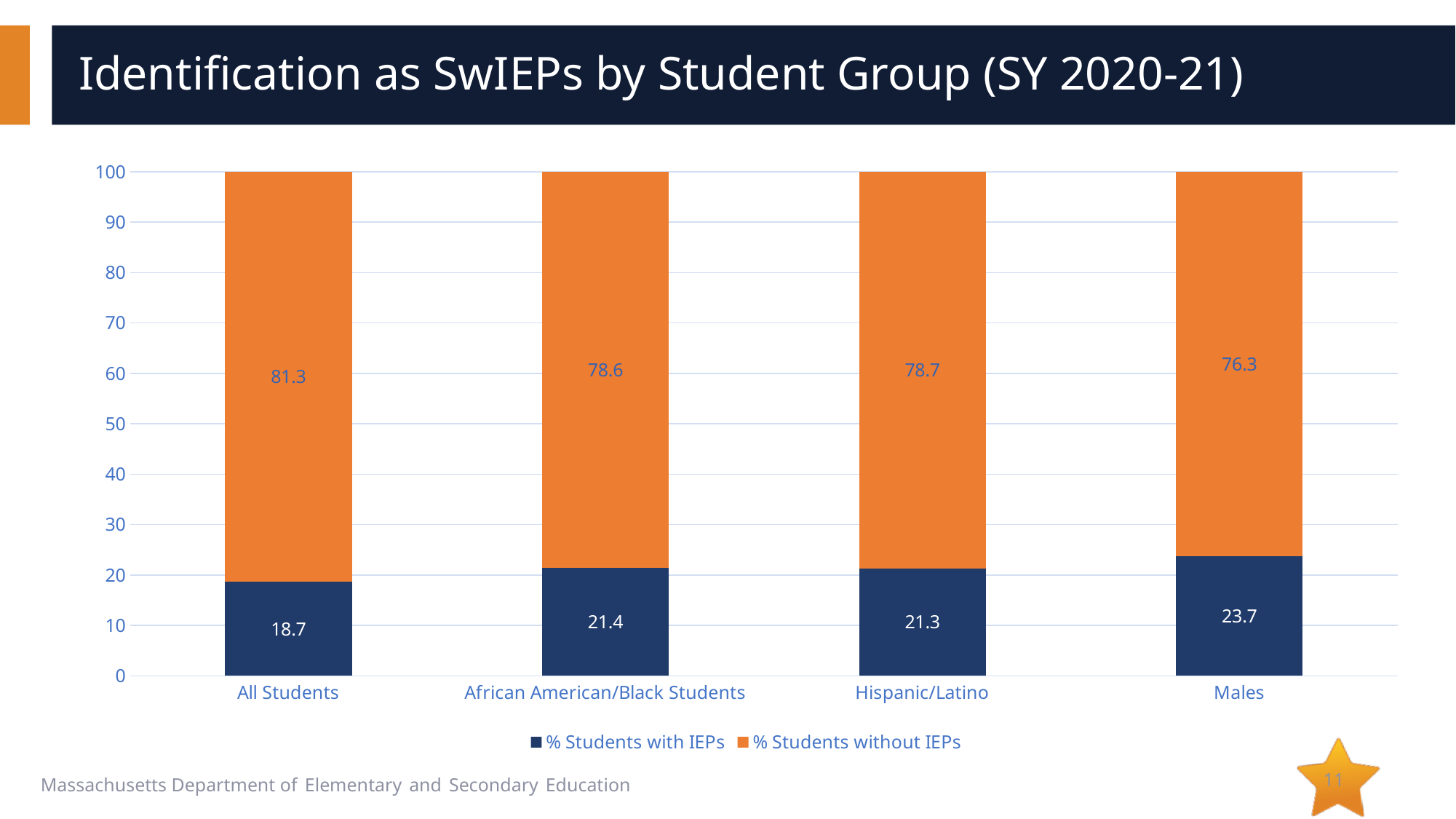
Which is larger: the % Students with IEPs for African American/Black Students or for All Students? African American/Black Students What is the total of the stacked bar for Hispanic/Latino? 100 What is the % Students with IEPs value for Hispanic/Latino? 21.3 How many student groups are shown on the x axis? 4 What is the % Students without IEPs value for African American/Black Students? 78.6 Which student group has the lowest % Students with IEPs? All Students Which student group has the highest % Students with IEPs? Males What is the difference between the % Students with IEPs for Males and for All Students? 5 What is the % Students without IEPs value for Males? 76.3 What is the % Students with IEPs value for All Students? 18.7 What kind of chart is shown on the slide? Stacked bar chart How many series does the legend list? 2